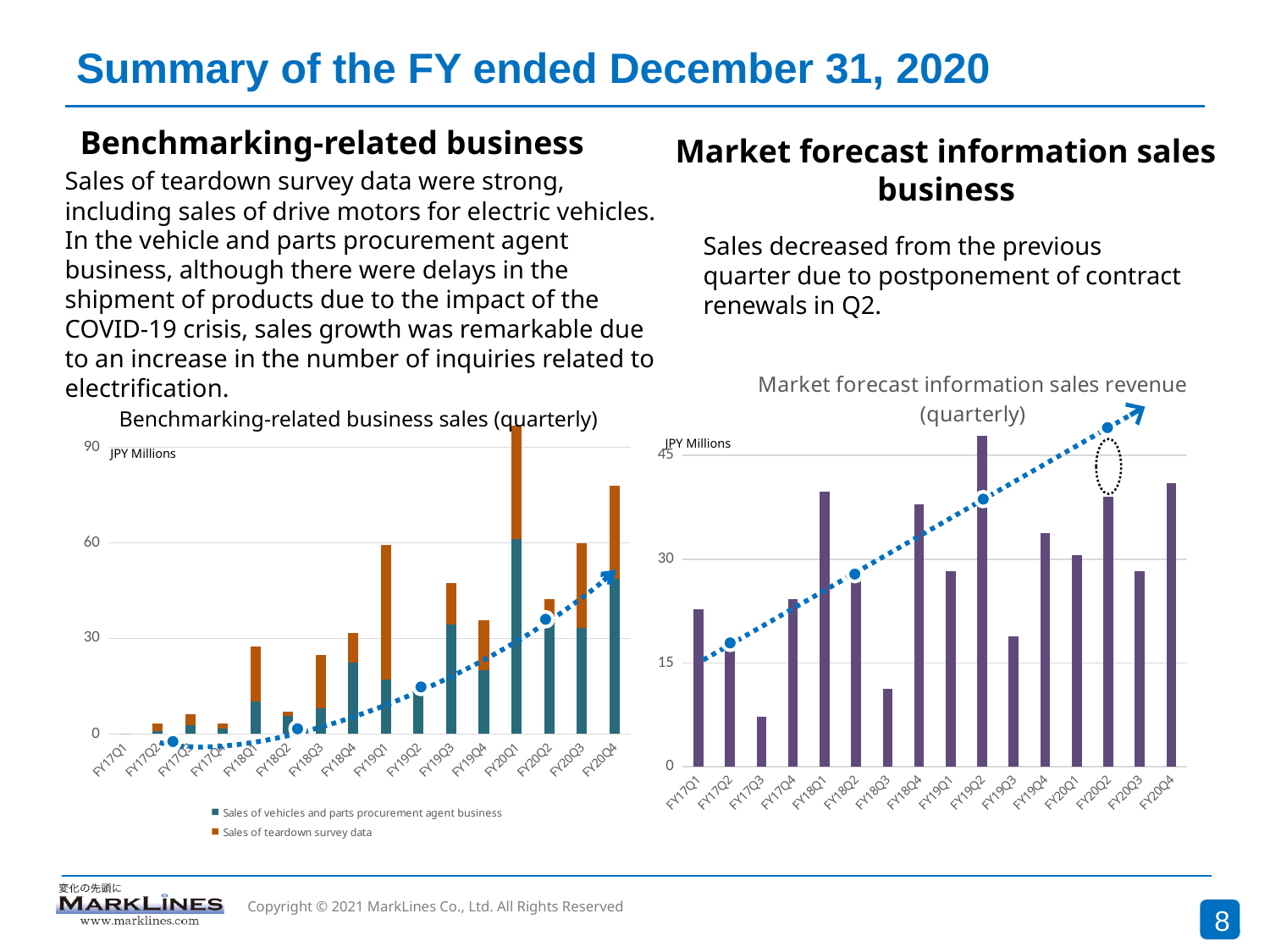
In the 'Market forecast information sales revenue (quarterly)' chart, is the value for FY17Q3 greater or less than 15? less In the 'Market forecast information sales revenue (quarterly)' chart, which quarter has the lowest revenue? FY17Q3 What kind of chart is the 'Market forecast information sales revenue (quarterly)' chart? Bar chart In the 'Market forecast information sales revenue (quarterly)' chart, which quarter has the highest revenue? FY19Q2 How many quarters are shown on the x axis of the 'Market forecast information sales revenue (quarterly)' chart? 16 In the 'Benchmarking-related business sales (quarterly)' chart, is the total for FY20Q4 greater or less than 60? greater In the 'Market forecast information sales revenue (quarterly)' chart, which is larger, FY18Q1 or FY18Q2? FY18Q1 In the 'Market forecast information sales revenue (quarterly)' chart, is the value for FY20Q4 greater or less than 30? greater How many series does the legend of the 'Benchmarking-related business sales (quarterly)' chart list? 2 What kind of chart is the 'Benchmarking-related business sales (quarterly)' chart? Stacked bar chart In the 'Benchmarking-related business sales (quarterly)' chart, which quarter has the tallest stacked bar? FY20Q1 In the 'Benchmarking-related business sales (quarterly)' chart, what are the two legend entries? Sales of vehicles and parts procurement agent business; Sales of teardown survey data